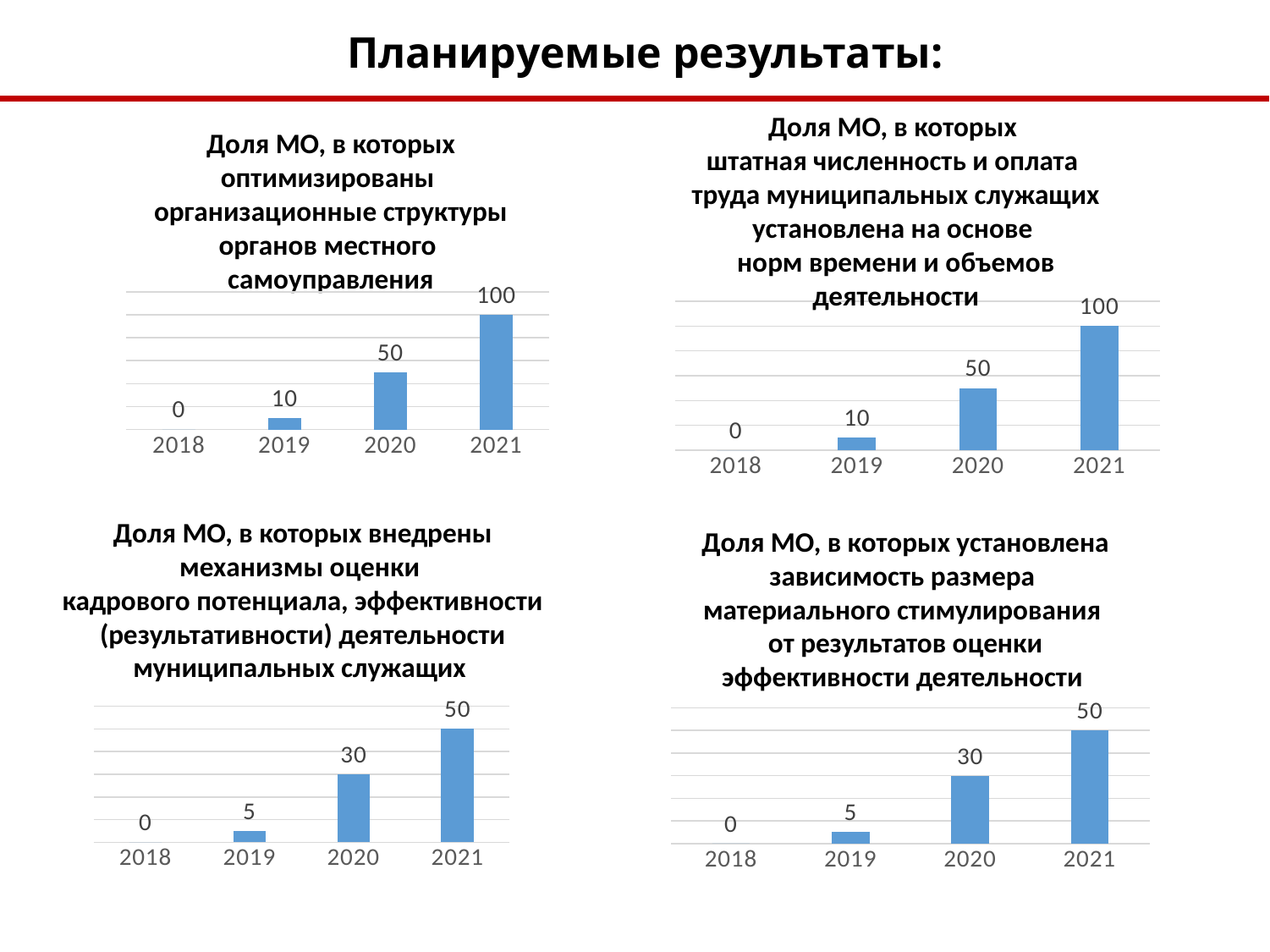
In the top-right chart, do the values rise or fall from 2018 to 2021? rise In the bottom-left chart, what is the value for 2020? 30 In the bottom-right chart, which year has the lowest value? 2018 In the bottom-right chart, which is larger: the value for 2019 or the value for 2020? 2020 In the top-left chart, which year has the highest value? 2021 What kind of chart is the bottom-left chart? bar chart How many years are shown on the x axis of the top-left chart? 4 In the top-right chart, what is the difference between the values for 2021 and 2020? 50 In the bottom-right chart, what is the value for 2021? 50 In the top-left chart, what is the value for 2020? 50 In the top-right chart, what is the value for 2019? 10 In the bottom-left chart, what is the difference between the values for 2020 and 2019? 25